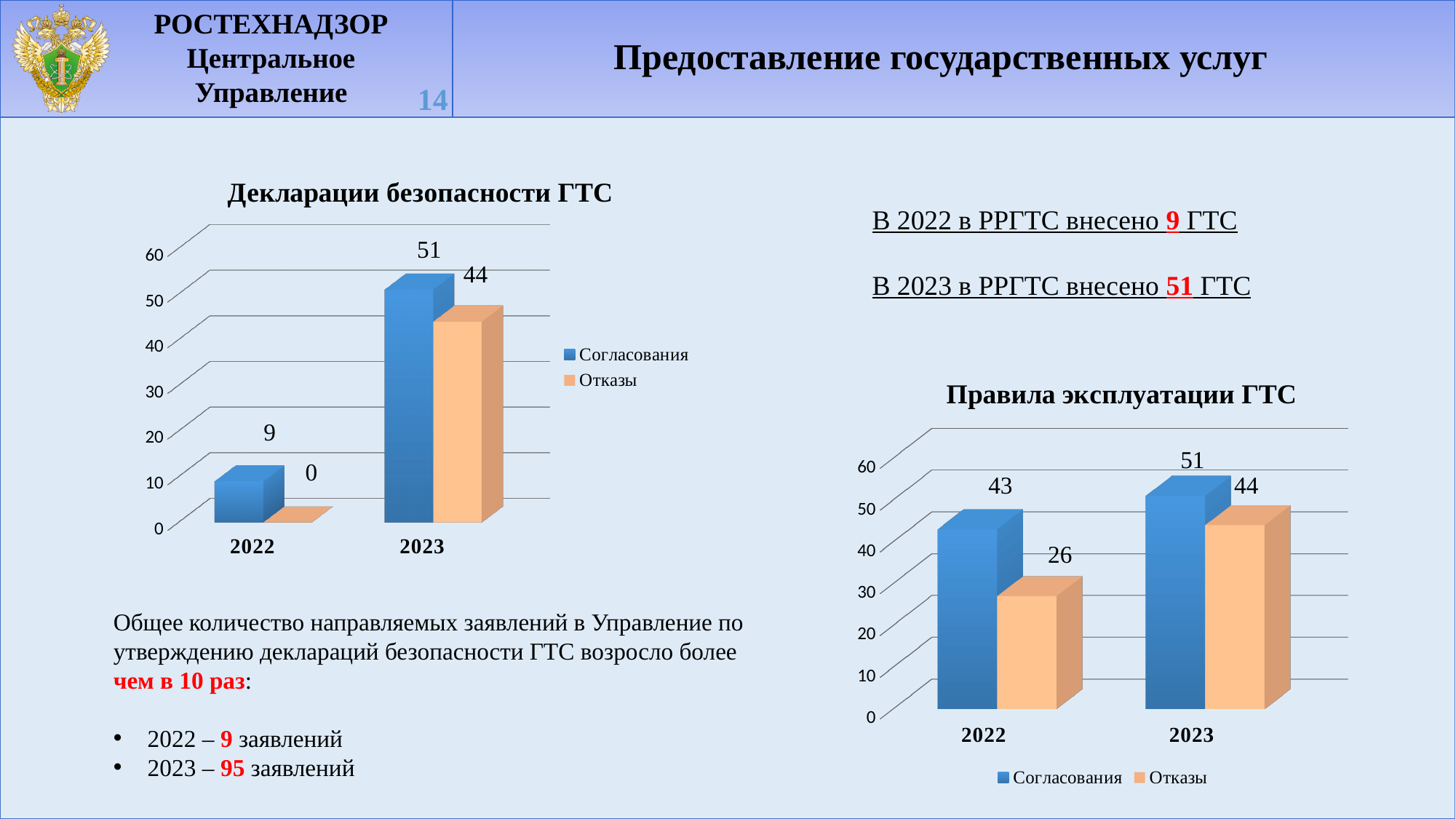
In the chart "Правила эксплуатации ГТС", what is the difference between Отказы in 2023 and Отказы in 2022? 18 In the chart "Декларации безопасности ГТС", what is the difference between Согласования in 2023 and Согласования in 2022? 42 What kind of chart is "Правила эксплуатации ГТС"? bar chart In the chart "Правила эксплуатации ГТС", which year has the lowest value for Согласования? 2022 In the chart "Правила эксплуатации ГТС", do the Согласования values rise or fall from 2022 to 2023? rise In the chart "Правила эксплуатации ГТС", what is the value of Согласования for 2023? 51 In the chart "Декларации безопасности ГТС", which series has the higher value in 2023, Согласования or Отказы? Согласования In the chart "Правила эксплуатации ГТС", what is the value of Отказы for 2022? 26 How many year categories are shown on the x axis of the chart "Декларации безопасности ГТС"? 2 In the chart "Декларации безопасности ГТС", how many series does the legend list? 2 In the chart "Декларации безопасности ГТС", what is the value of Согласования for 2023? 51 In the chart "Декларации безопасности ГТС", what is the value of Отказы for 2022? 0